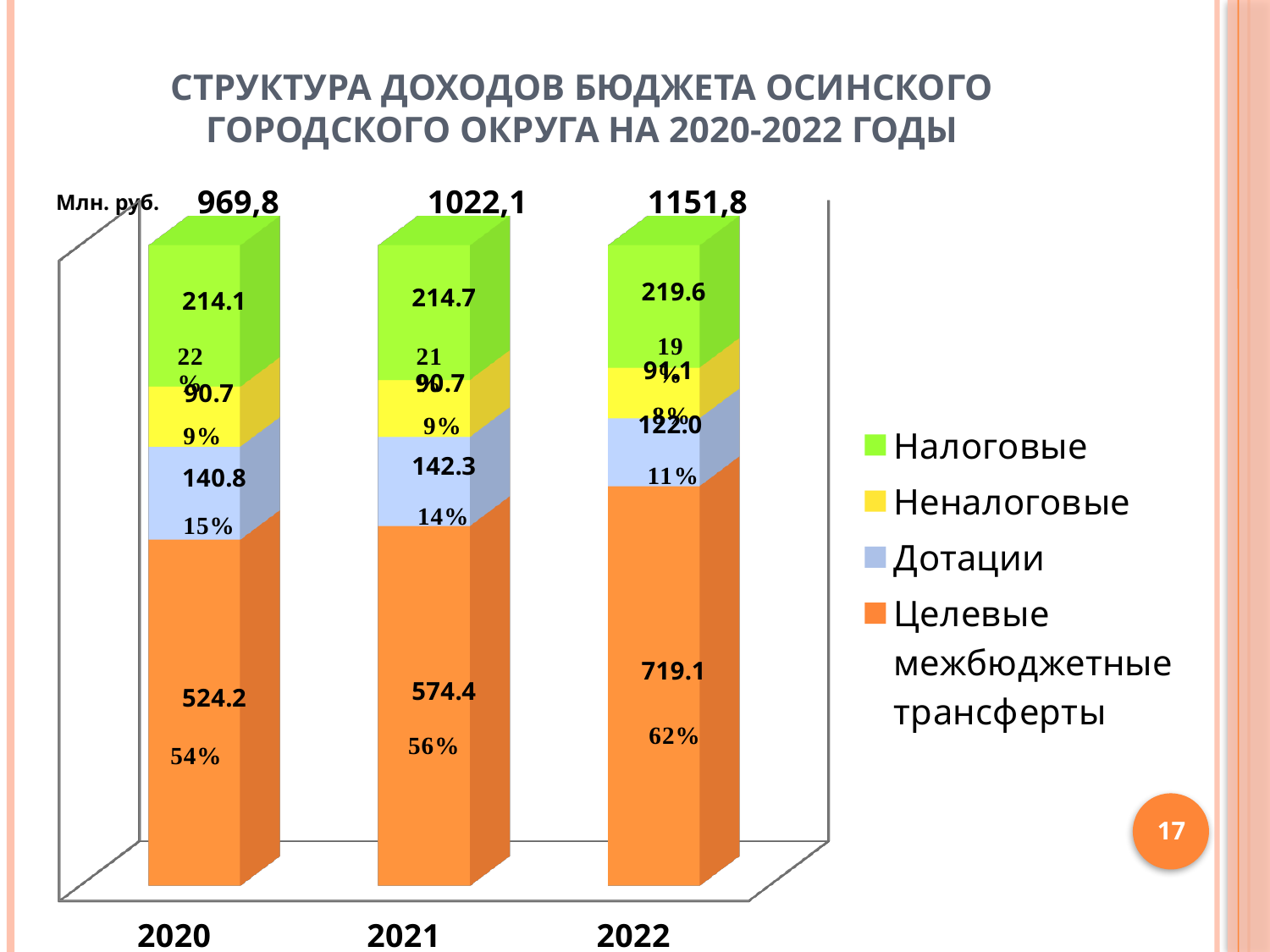
Which year has the highest total budget income? 2022 What type of chart is shown on the slide? stacked bar chart What is the difference between Целевые межбюджетные трансферты in 2022 and in 2021? 144.7 What is the value of Дотации for 2021? 142.3 What is the value of Целевые межбюджетные трансферты for 2022? 719.1 How many years (categories) are shown on the x axis? 3 What is the value of Налоговые for 2020? 214.1 Which is larger: Дотации in 2021 or Дотации in 2022? Дотации in 2021 What is the total shown above the bar for 2022? 1151,8 What percentage share do Целевые межбюджетные трансферты make up in 2022? 62% Which year has the lowest value for Целевые межбюджетные трансферты? 2020 How many series does the legend list? 4